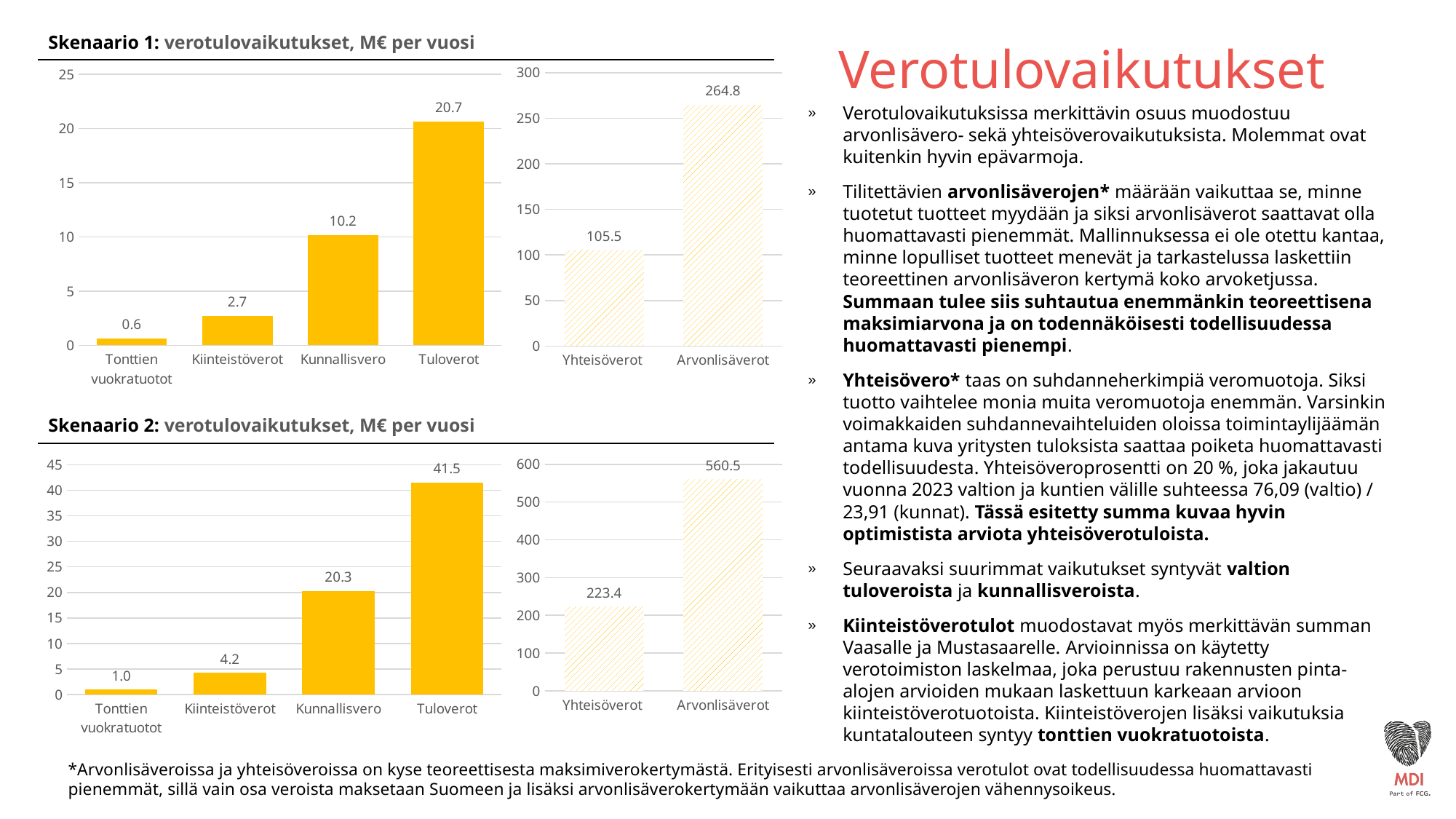
In the Skenaario 2 left-hand chart, what is the difference between Tuloverot and Kunnallisvero? 21.2 In the Skenaario 2 left-hand chart, which category has the highest value? Tuloverot In the Skenaario 1 left-hand chart, which category has the lowest value? Tonttien vuokratuotot In the Skenaario 1 right-hand chart, what is the value for Arvonlisäverot? 264.8 In the Skenaario 1 right-hand chart, what is the difference between Arvonlisäverot and Yhteisöverot? 159.3 What type of chart is the Skenaario 2 left-hand chart? Bar chart In the Skenaario 2 left-hand chart, what is the value for Kunnallisvero? 20.3 In the Skenaario 2 right-hand chart, which is larger, Yhteisöverot or Arvonlisäverot? Arvonlisäverot In the Skenaario 2 right-hand chart, what is the value for Yhteisöverot? 223.4 How many categories are shown in the Skenaario 1 left-hand chart? 4 In the Skenaario 1 left-hand chart, what is the value for Tuloverot? 20.7 What is the title of the top chart group on the slide? Skenaario 1: verotulovaikutukset, M€ per vuosi